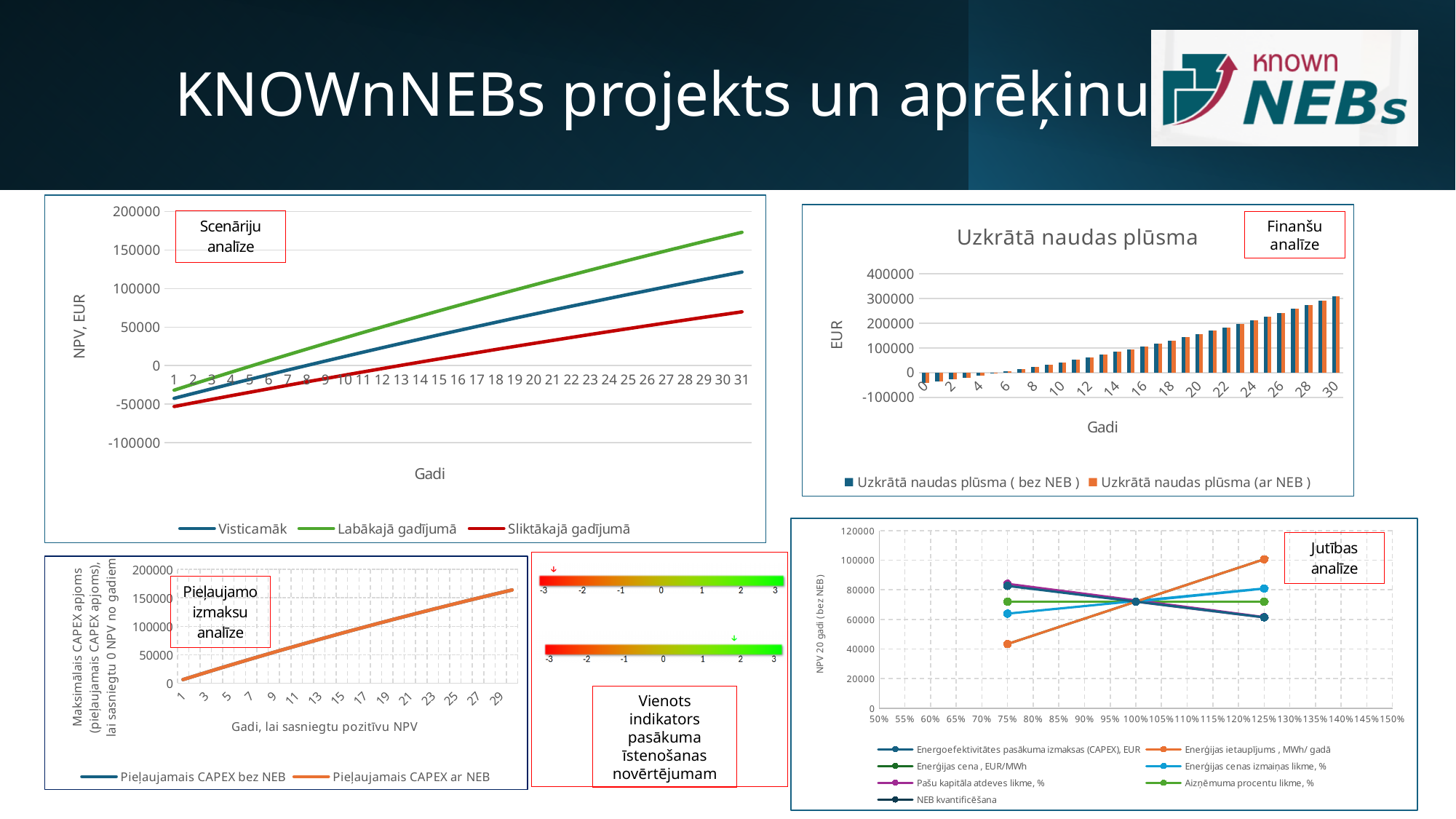
In the Uzkrātā naudas plūsma chart (top right), is the value for Uzkrātā naudas plūsma (ar NEB) at year 30 greater or less than 200000? greater In the Scenāriju analīze chart (top left), which series has the lowest value at year 31? Sliktākajā gadījumā In the Scenāriju analīze chart (top left), how many series does the legend list? 3 In the Uzkrātā naudas plūsma chart (top right), how many series does the legend list? 2 In the Scenāriju analīze chart (top left), which series has the highest value at year 31? Labākajā gadījumā In the Scenāriju analīze chart (top left), what kind of chart is it? line chart In the Scenāriju analīze chart (top left), is the value for Labākajā gadījumā at year 31 greater or less than 150000? greater In the Pieļaujamo izmaksu analīze chart (bottom left), how many series does the legend list? 2 In the Scenāriju analīze chart (top left), do the values rise or fall along the x axis? rise In the Uzkrātā naudas plūsma chart (top right), what kind of chart is it? bar chart